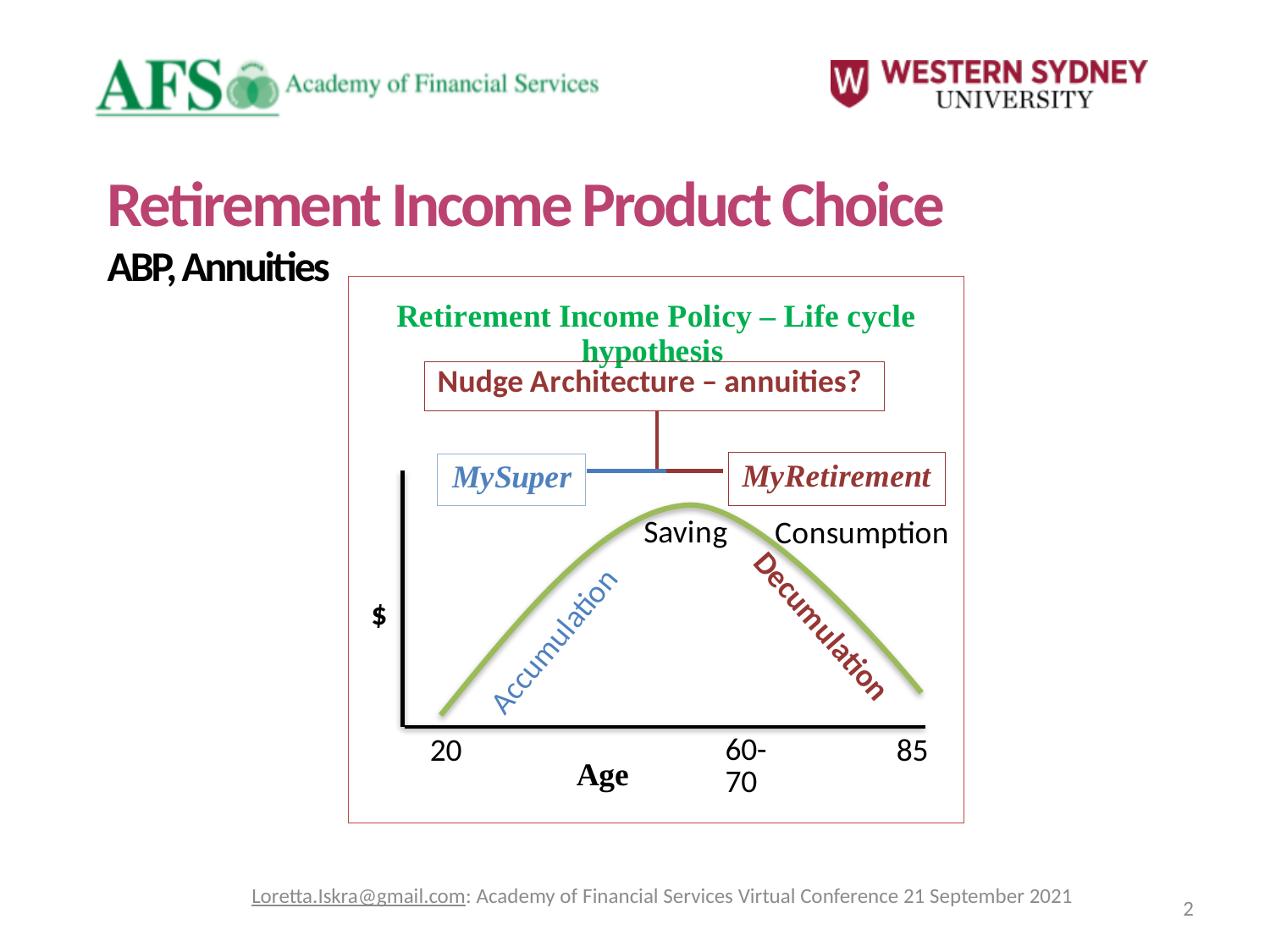
What label is on the x axis of the chart? Age What is the title of the chart? Retirement Income Policy – Life cycle hypothesis Does the curve rise or fall between age 20 and age 60-70? rise What kind of chart is shown on the slide? line chart Which is higher on the curve, the value at age 20 or the value at age 60-70? 60-70 At which age marked on the x axis does the curve reach its highest point? 60-70 How many age values are marked along the x axis? 3 Which is higher on the curve, the value at age 85 or the value at age 60-70? 60-70 Does the curve rise or fall between age 60-70 and age 85? fall